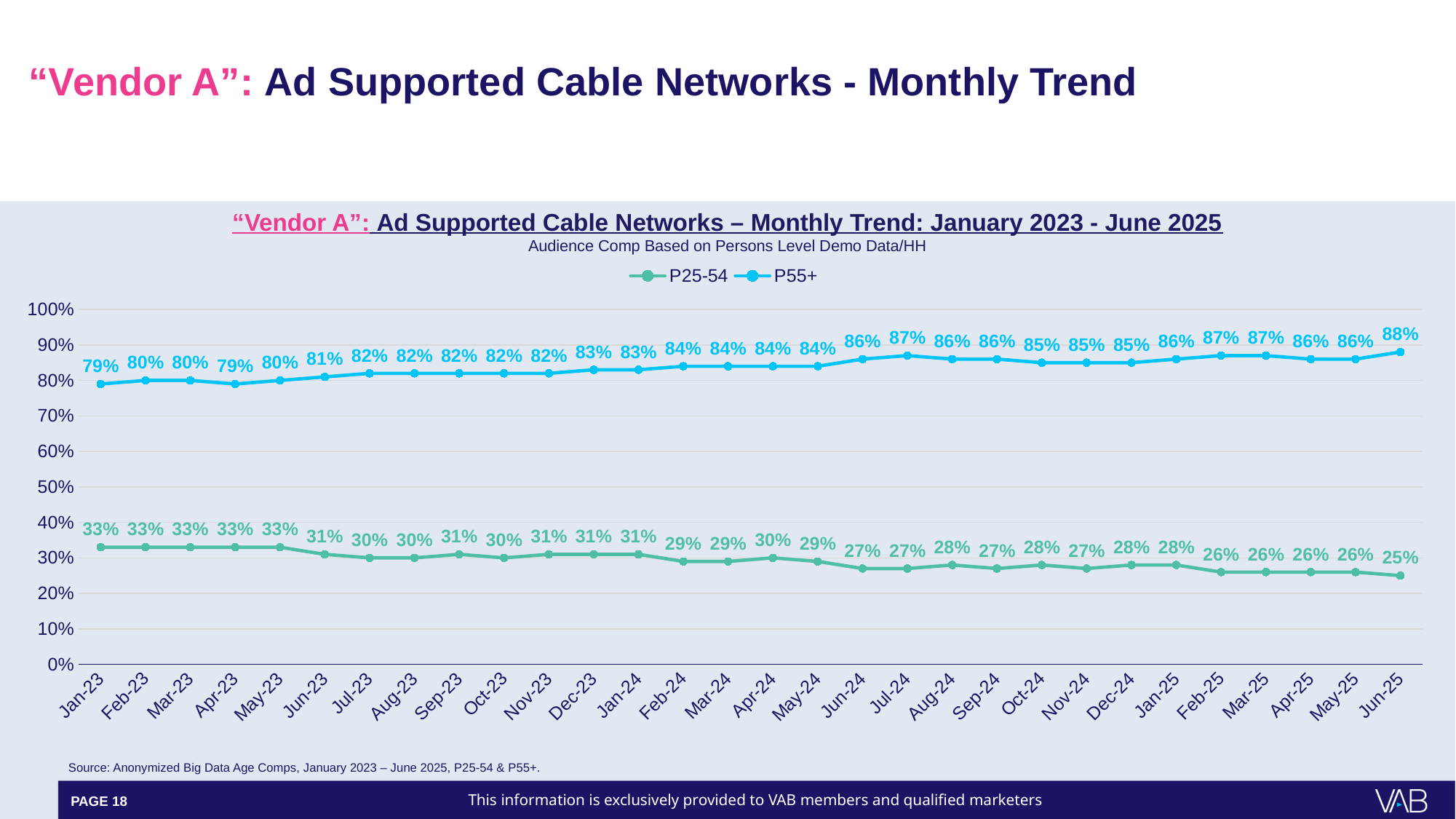
In which month does the P55+ series reach its highest value? Jun-25 In which month does the P25-54 series reach its lowest value? Jun-25 Does the P25-54 series generally rise or fall from Jan-23 to Jun-25? Fall What is the P25-54 value for Jul-24? 27% What kind of chart is shown on the slide? Line chart What is the P55+ value for Jan-23? 79% What is the difference between the P55+ and P25-54 values in Jun-25? 63 percentage points Which series is drawn in blue according to the legend? P55+ What is the P25-54 value for Jun-25? 25% How many series does the legend list? 2 How many monthly data points are plotted for each series? 30 Which is larger for P55+: the value in Jul-24 or the value in Jan-24? Jul-24